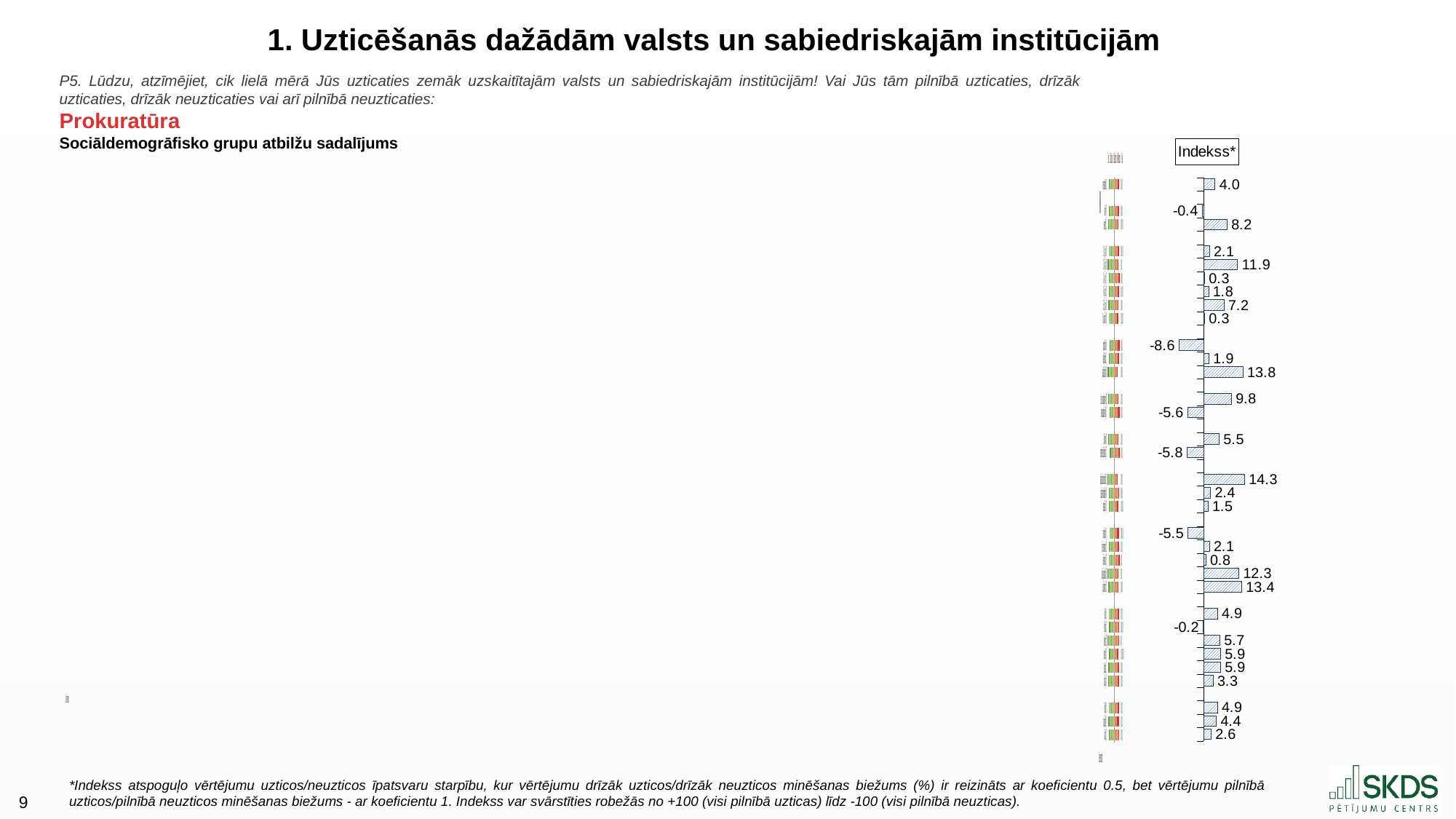
In the Indekss* chart, what is the highest index value shown? 14.3 In the Indekss* chart, what is the difference between the highest value (14.3) and the lowest value (-8.6)? 22.9 In the Indekss* chart, how many bars have a negative value? 6 In the Indekss* chart, what is the smallest positive value shown? 0.3 What kind of chart is the Indekss* chart? bar chart Which institution does the chart on this slide refer to? Prokuratūra In the Indekss* chart, what is the second-highest index value shown? 13.8 In the Indekss* chart, how many bars are plotted in total? 33 What is the title shown above the index chart on the right of the slide? Indekss* In the Indekss* chart, which is larger: the value 13.8 or the value 13.4? 13.8 In the Indekss* chart, what is the lowest index value shown? -8.6